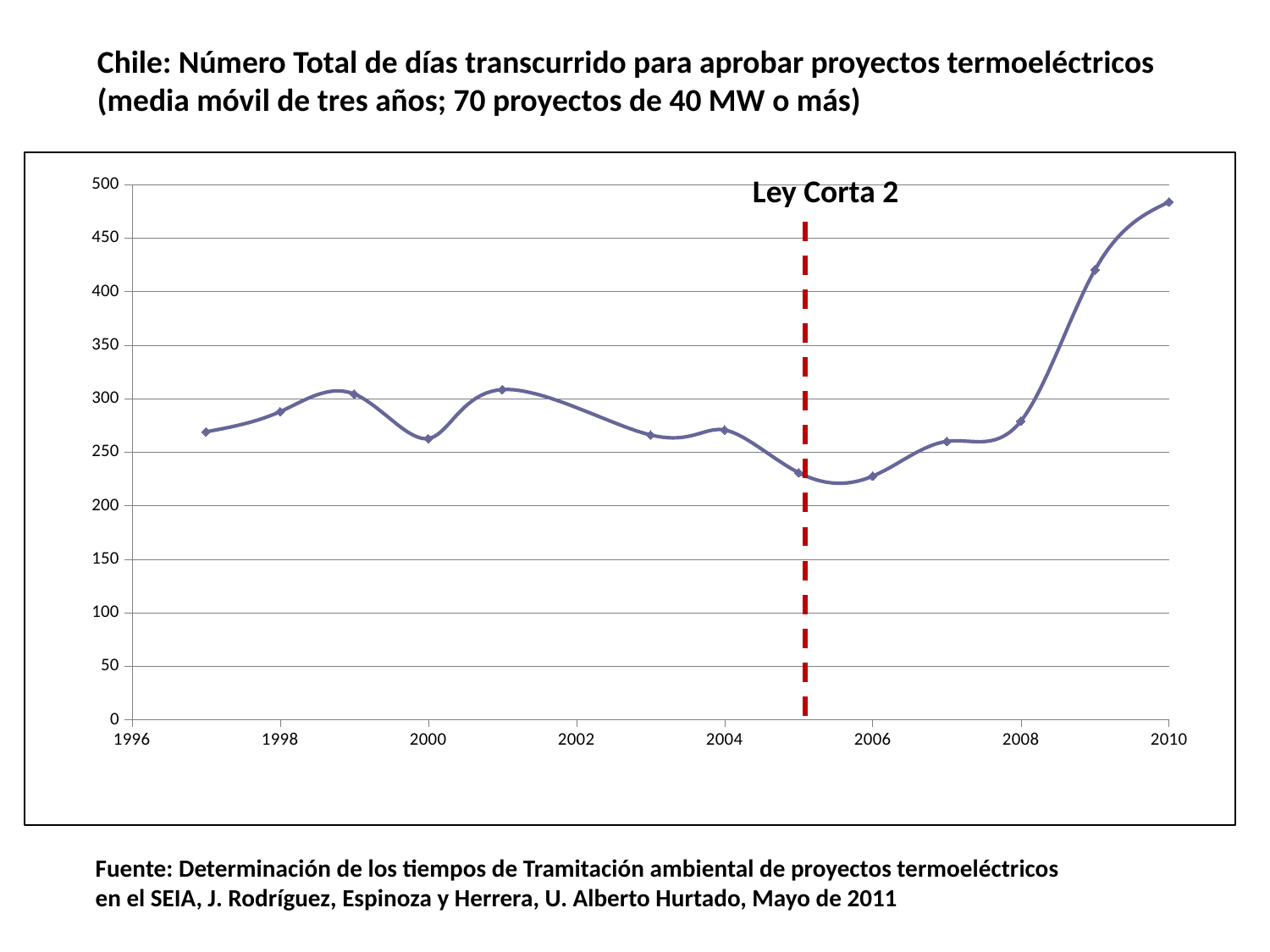
Is the value for 1997 greater or less than 250? greater Which year has the larger value, 2010 or 1997? 2010 Which year has the larger value, 2009 or 2005? 2009 What label is written next to the red dashed vertical line on the chart? Ley Corta 2 Is the value for 2010 greater or less than 450? greater Is the value for 2006 greater or less than 250? less What kind of chart is shown on the slide? line chart Do the values rise or fall between 2006 and 2010? rise In which year does the line reach its highest value? 2010